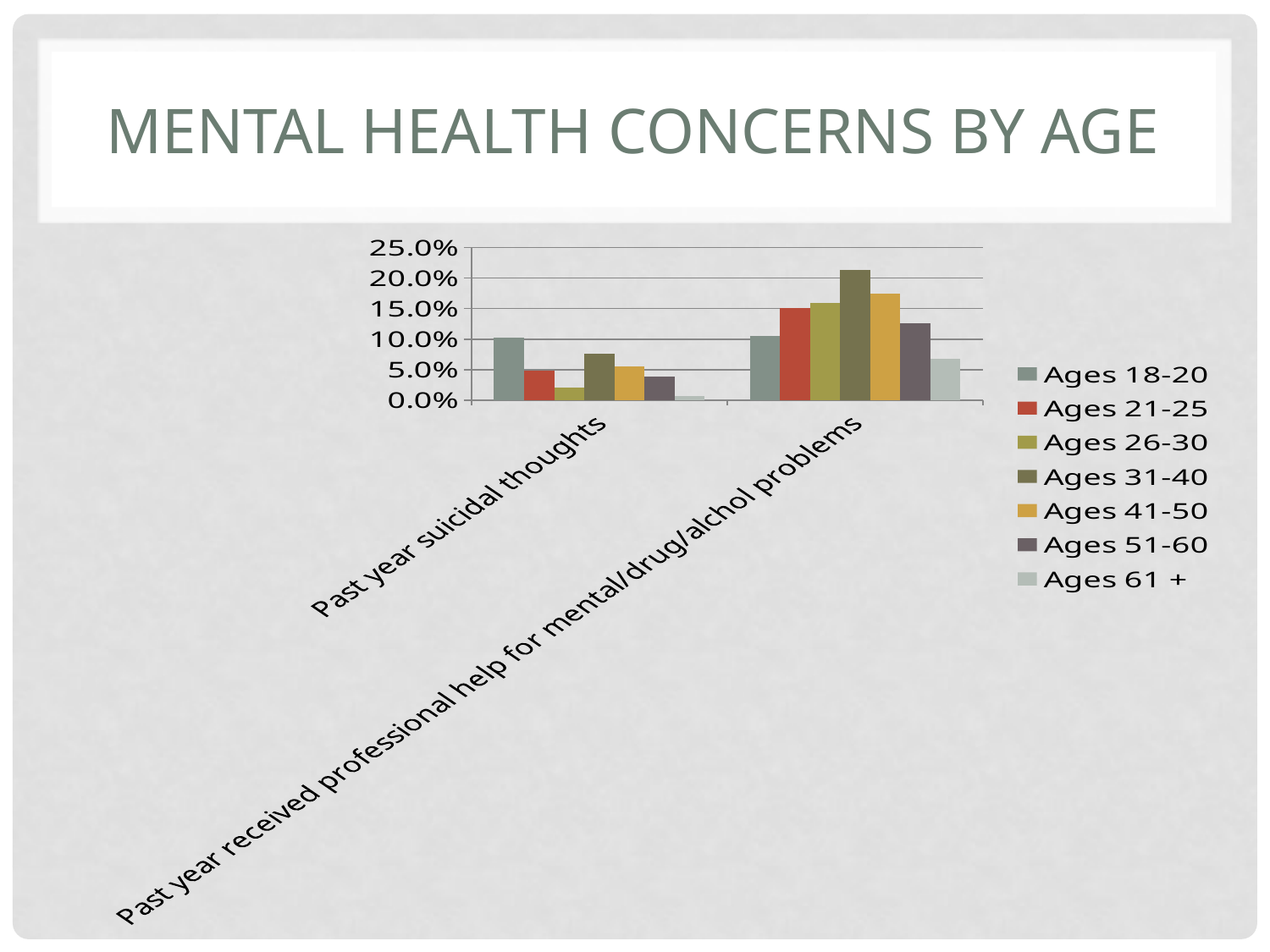
Which age group has the lowest value for 'Past year suicidal thoughts'? Ages 61 + What is the title of the slide containing the chart? Mental Health Concerns by Age Is the value for Ages 31-40 in 'Past year received professional help for mental/drug/alchol problems' greater or less than 20.0%? greater Is the value for Ages 26-30 in 'Past year suicidal thoughts' greater or less than 5.0%? less For 'Past year suicidal thoughts', which is larger: the value for Ages 31-40 or the value for Ages 21-25? Ages 31-40 Which age group has the highest value for 'Past year received professional help for mental/drug/alchol problems'? Ages 31-40 How many series does the chart's legend list? 7 How many categories are shown on the x axis of the chart? 2 What kind of chart is shown on the slide? Bar chart Which age group has the lowest value for 'Past year received professional help for mental/drug/alchol problems'? Ages 61 + Which age group has the highest value for 'Past year suicidal thoughts'? Ages 18-20 For 'Past year received professional help for mental/drug/alchol problems', which is larger: the value for Ages 41-50 or the value for Ages 51-60? Ages 41-50